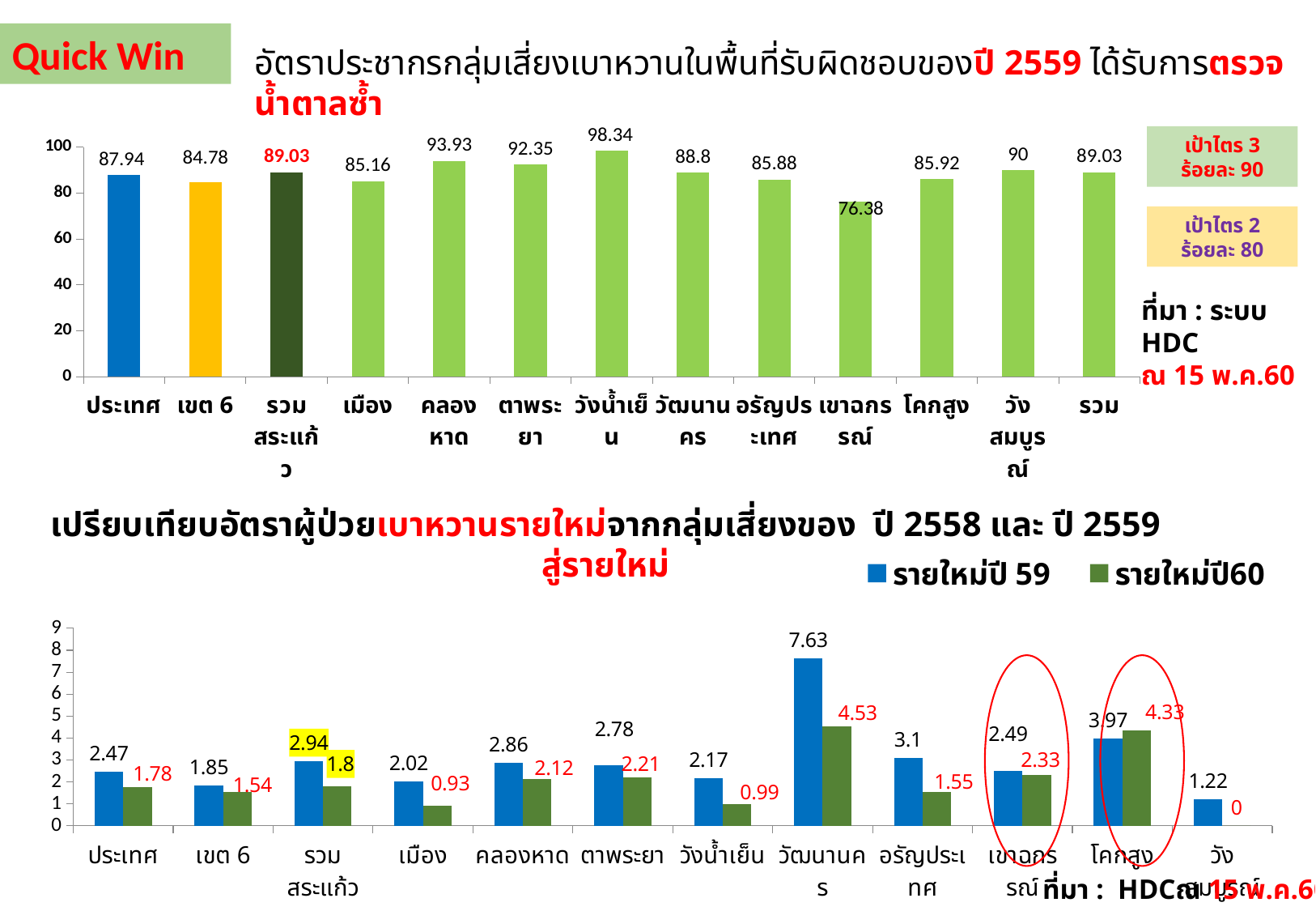
In the top chart, which category has the highest value? วังน้ำเย็น In the top chart, is the value for เขาฉกรรณ์ greater or less than 80? less What kind of chart is the bottom chart? bar chart In the bottom chart, what is the value for วัฒนานคร in the รายใหม่ปี 59 series? 7.63 In the bottom chart, what is the difference between the รายใหม่ปี 59 and รายใหม่ปี60 values for วัฒนานคร? 3.1 In the top chart, what is the value for วังน้ำเย็น? 98.34 In the bottom chart, which is larger for โคกสูง: รายใหม่ปี 59 or รายใหม่ปี60? รายใหม่ปี60 In the bottom chart, how many series does the legend list? 2 In the top chart, what is the difference between the values for คลองหาด and เมือง? 8.77 In the top chart, how many categories are shown on the x axis? 13 In the top chart, which category has the lowest value? เขาฉกรรณ์ In the bottom chart, what is the value for โคกสูง in the รายใหม่ปี60 series? 4.33